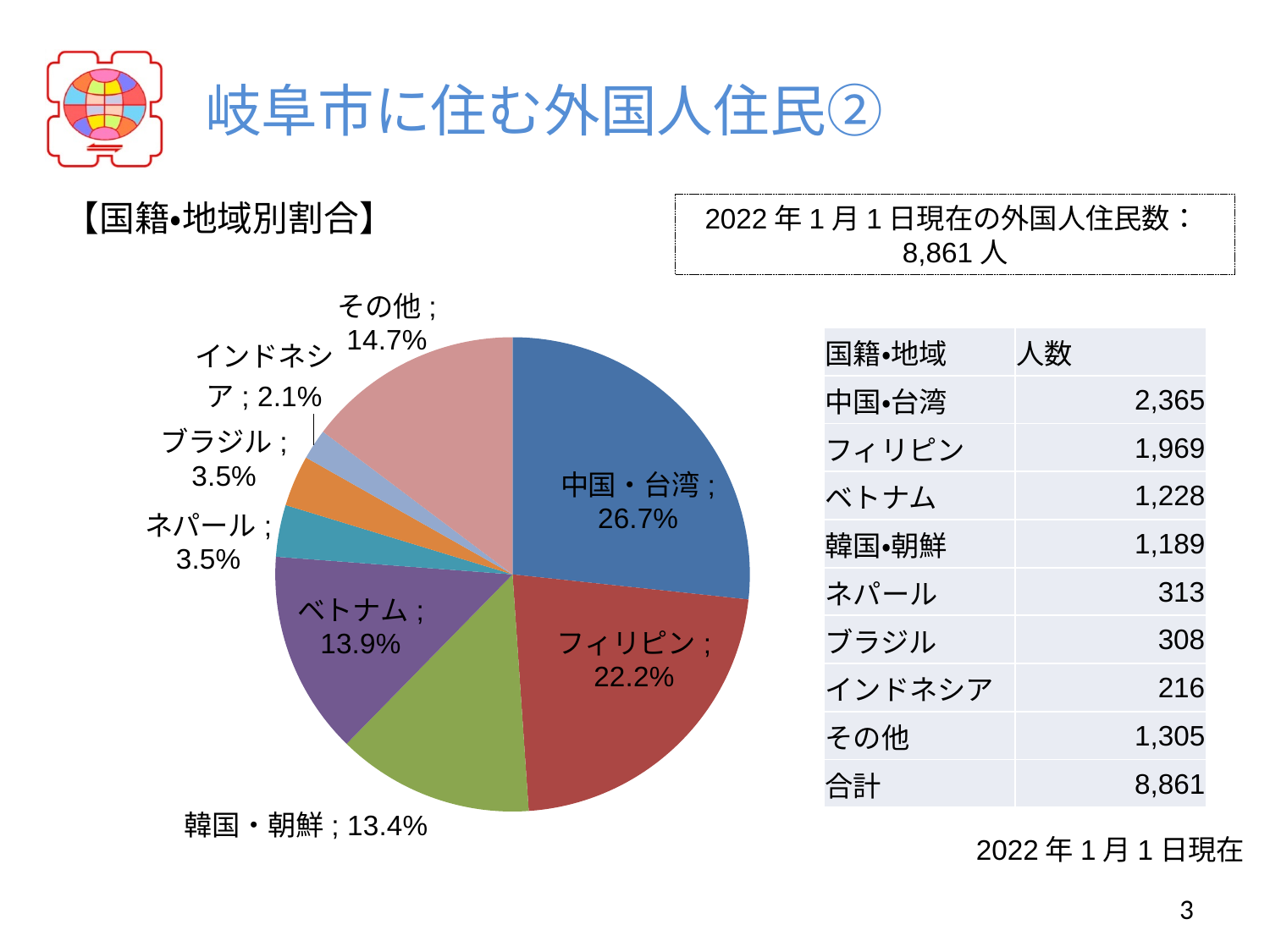
What is the combined percentage of ブラジル and インドネシア in the pie chart? 5.6% What type of chart is shown on the slide? pie chart Which category has the largest slice in the pie chart? 中国・台湾 What share of the pie chart does 中国・台湾 represent? 26.7% What percentage is shown for フィリピン in the pie chart? 22.2% How many slices does the pie chart have? 8 What is the difference in percentage points between 中国・台湾 and フィリピン in the pie chart? 4.5 What percentage is shown for その他 in the pie chart? 14.7% What percentage is shown for ベトナム in the pie chart? 13.9% Which category has the smallest slice in the pie chart? インドネシア Which slice is larger in the pie chart, ベトナム or 韓国・朝鮮? ベトナム What percentage is shown for ネパール in the pie chart? 3.5%